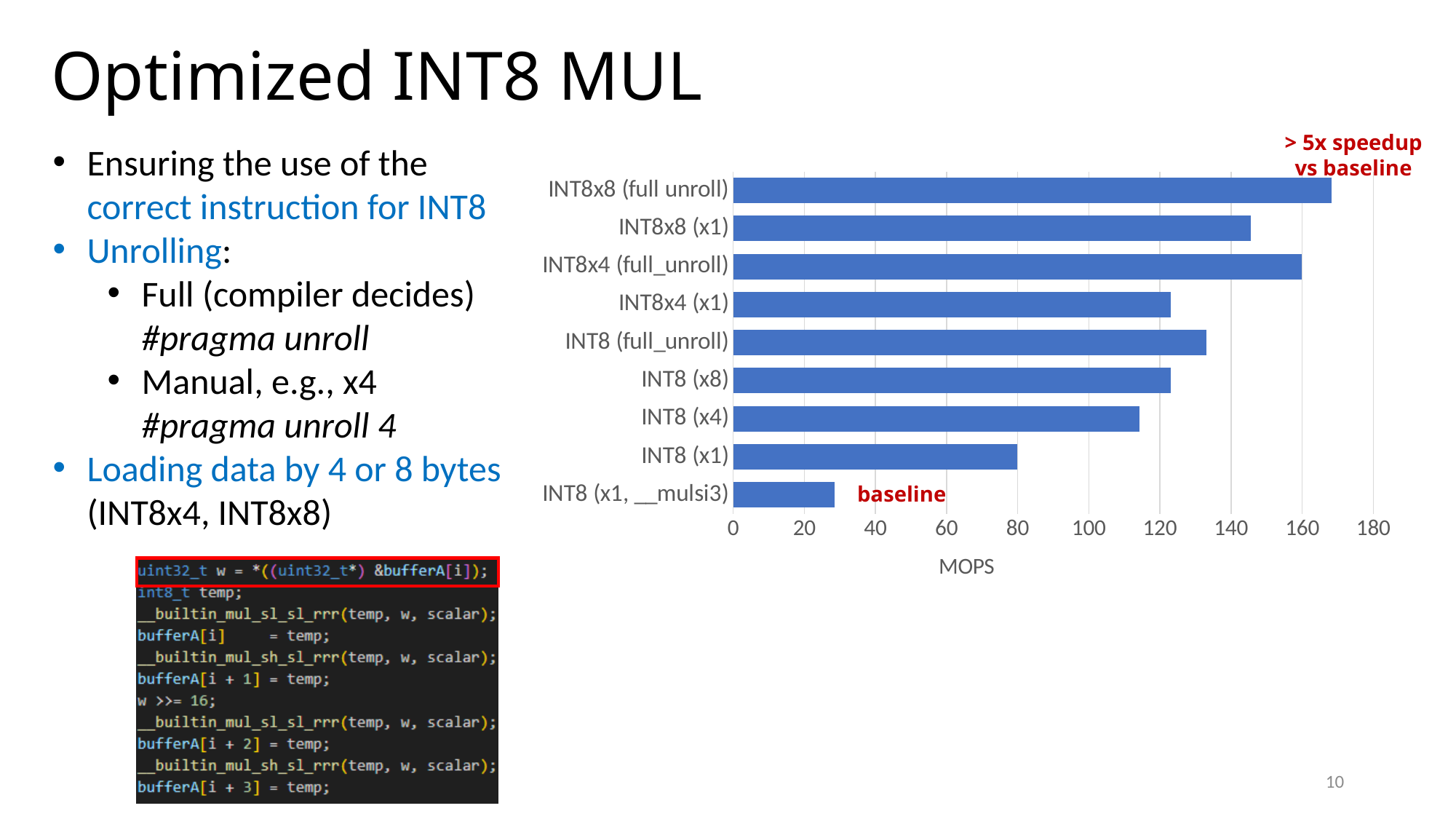
Is the value for INT8x8 (full unroll) greater or less than 160? greater Which bar is annotated as the baseline in the chart? INT8 (x1, __mulsi3) What is the label of the horizontal axis of the chart? MOPS Which category has the lowest MOPS value? INT8 (x1, __mulsi3) How many categories (bars) does the chart show? 9 Is the value for INT8x4 (x1) greater or less than 120? greater Which is larger, the value for INT8x4 (full_unroll) or the value for INT8x8 (x1)? INT8x4 (full_unroll) Which category has the highest MOPS value? INT8x8 (full unroll) Is the value for INT8 (x4) greater or less than 120? less What kind of chart is shown on the slide? bar chart Which is larger, the value for INT8 (x4) or the value for INT8 (x1)? INT8 (x4)